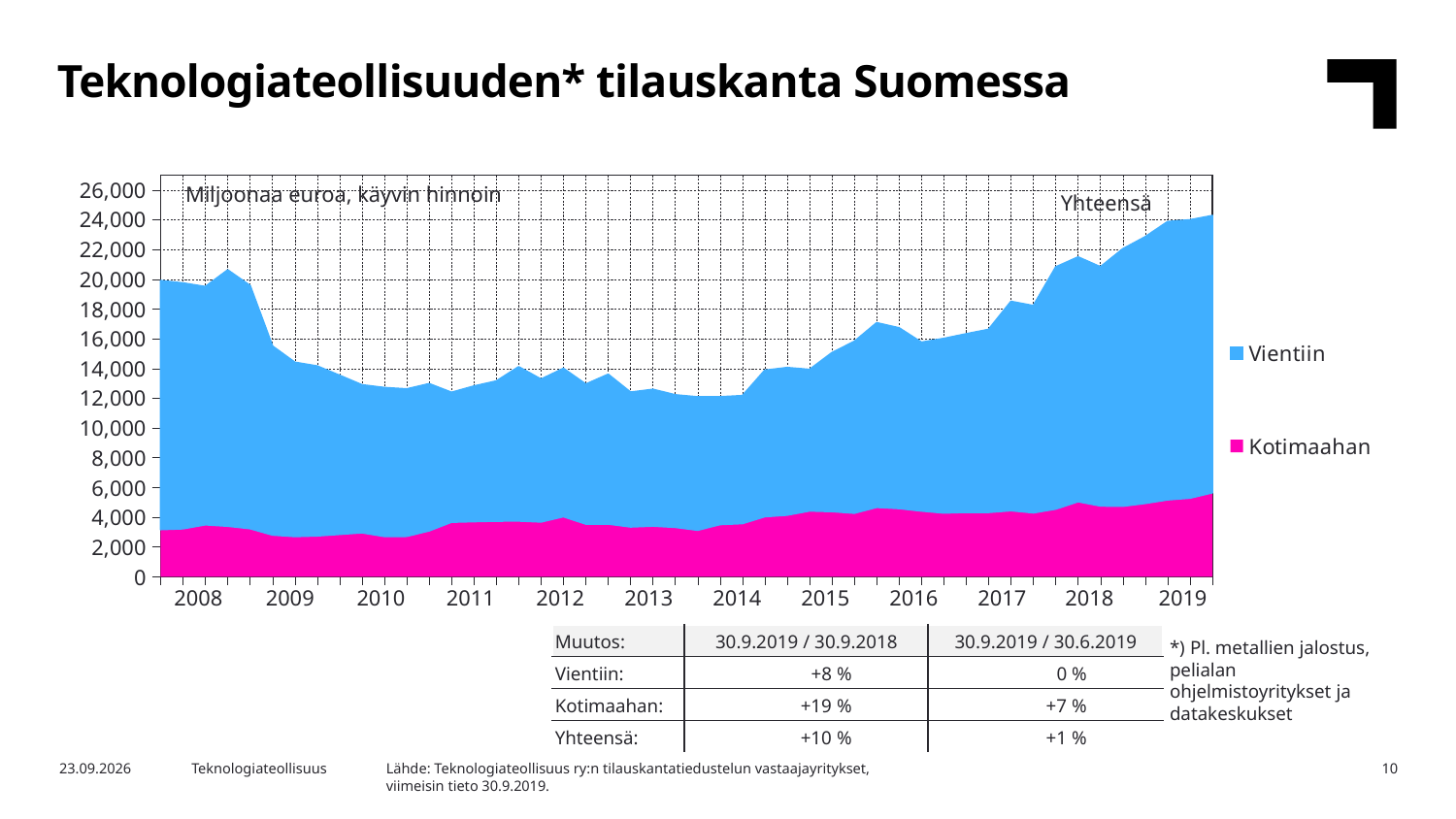
Does the total order book rise or fall from 2008 to 2010? fall Is the total (Yhteensä) value in 2013 greater or less than 14,000? less How many series does the legend list? 2 Is the Kotimaahan value in 2010 greater or less than 4,000? less Is the total (Yhteensä) value at the end of 2019 greater or less than 22,000? greater How many year labels are shown on the x axis? 12 Which two series are listed in the chart legend? Vientiin and Kotimaahan Does the total order book rise or fall from 2016 to 2019? rise In the table below the chart, what is the change for Vientiin between 30.9.2018 and 30.9.2019? +8 % Which series accounts for the larger part of the total order book throughout the period, Vientiin or Kotimaahan? Vientiin What kind of chart is shown on the slide? Stacked area chart What unit label is printed inside the chart area? Miljoonaa euroa, käyvin hinnoin